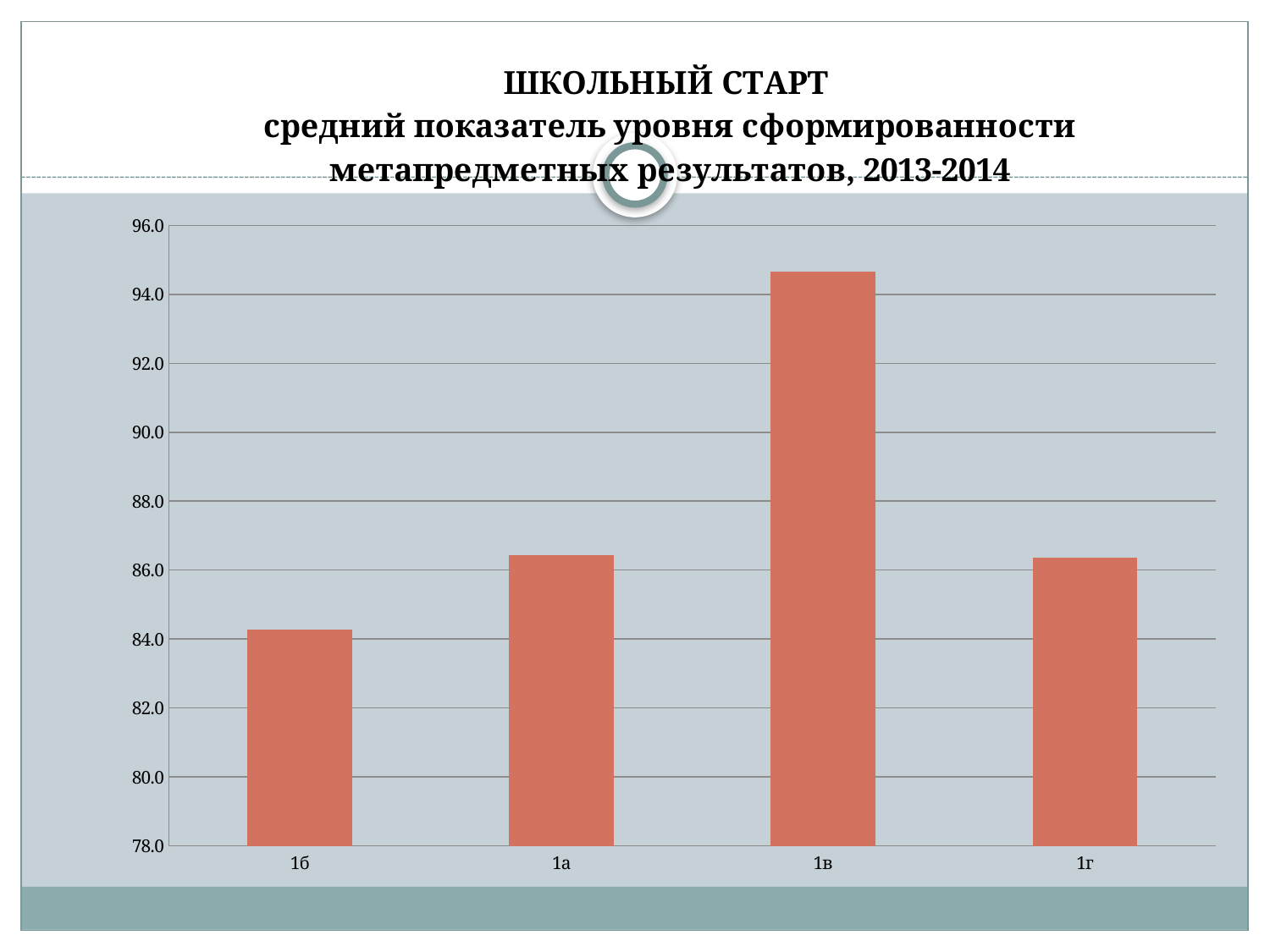
What kind of chart is shown on the slide? bar chart Which class has the lowest average indicator in the chart? 1б Which is larger, the value for 1б or the value for 1г? 1г Is the value for 1а greater or less than 84.0? greater Which is larger, the value for 1в or the value for 1а? 1в Is the value for 1в greater or less than 94.0? greater What school year is named in the chart's title? 2013-2014 Is the value for 1б greater or less than 86.0? less How many classes (categories) are shown on the x axis of the chart? 4 Which class has the highest average indicator in the chart? 1в What is the first line of the chart's title? ШКОЛЬНЫЙ СТАРТ